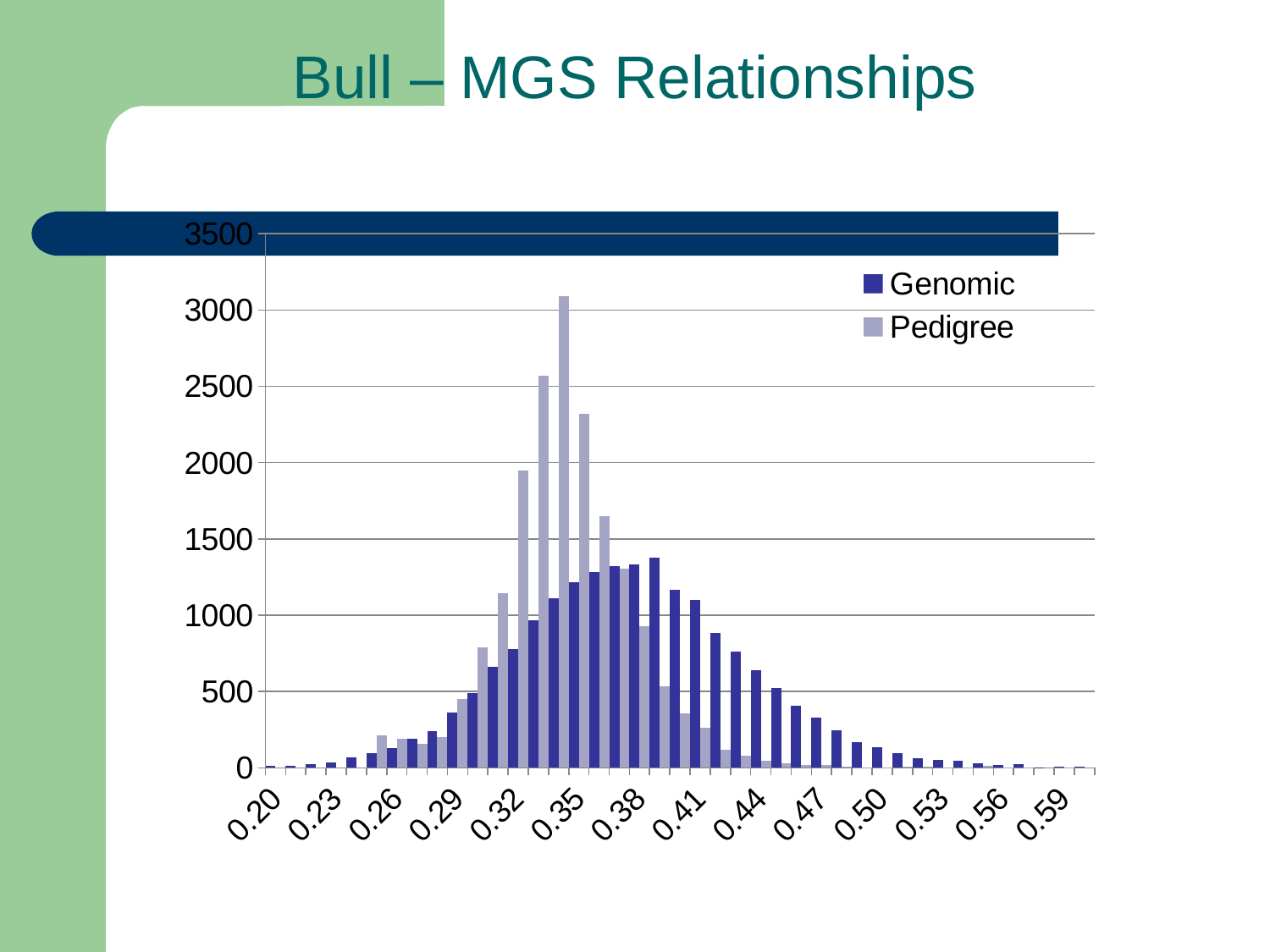
Is the Genomic value at 0.50 greater or less than 500? less What kind of chart is shown on the slide? bar chart At 0.35, which series has the larger value, Genomic or Pedigree? Pedigree Is the Genomic value at 0.35 greater or less than 1000? greater What are the two series named in the legend? Genomic and Pedigree At which x-axis value does the Pedigree series reach its highest bar? 0.34 How many labelled tick values are shown on the x axis? 14 What is the title of the slide containing the chart? Bull – MGS Relationships Is the Pedigree value at 0.47 greater or less than 500? less At 0.44, which series has the larger value, Genomic or Pedigree? Genomic How many series does the legend list? 2